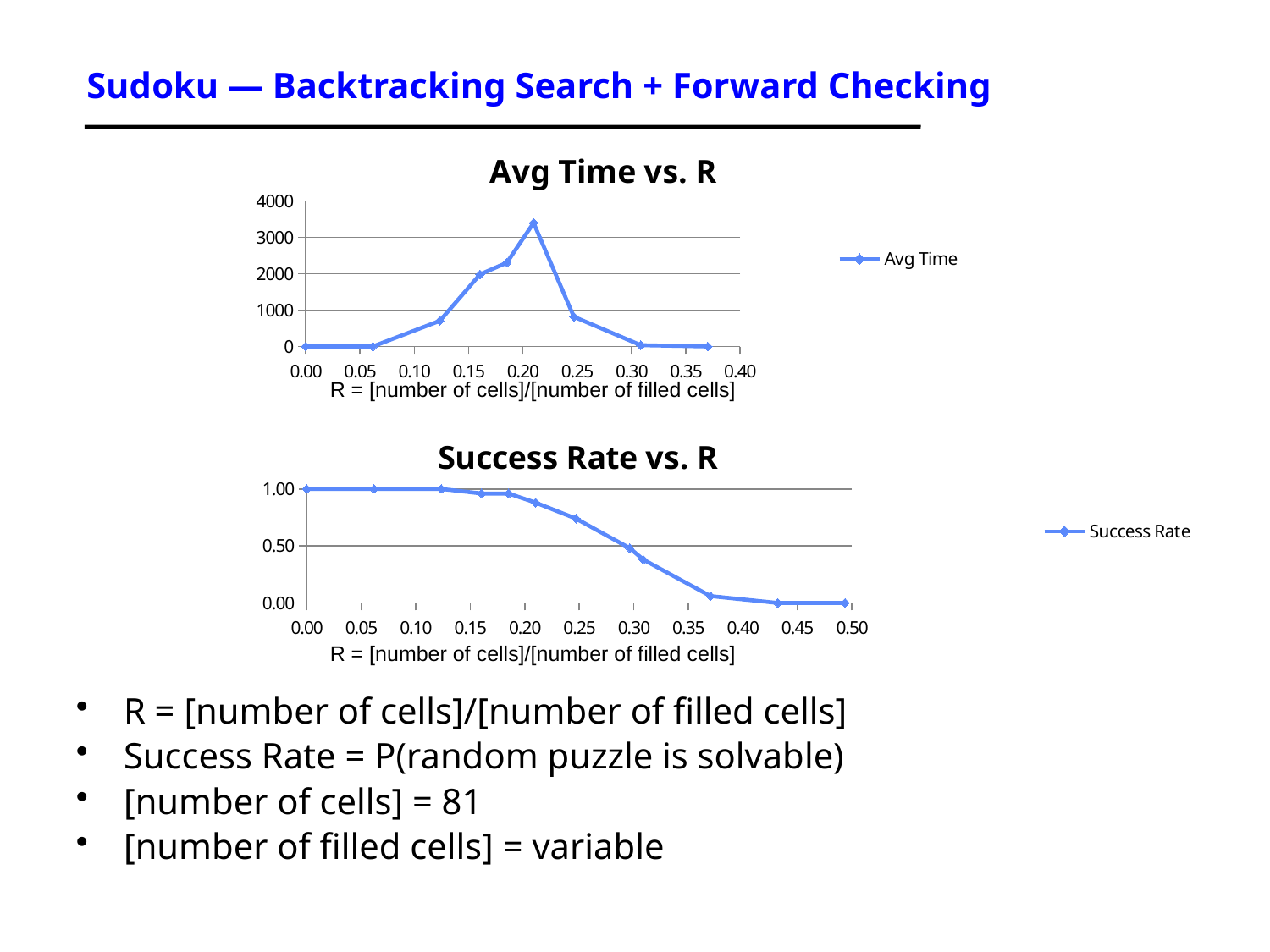
What is the legend entry of the "Avg Time vs. R" chart? Avg Time What kind of chart is the "Avg Time vs. R" chart? line chart How many series does the legend of the "Success Rate vs. R" chart list? 1 What is the x-axis title of the "Success Rate vs. R" chart? R = [number of cells]/[number of filled cells] In the "Avg Time vs. R" chart, is the highest plotted value greater or less than 3000? greater In the "Success Rate vs. R" chart, is the value at R = 0.50 greater or less than 0.50? less In the "Success Rate vs. R" chart, is the value at R = 0.00 greater or less than 0.50? greater How many series does the legend of the "Avg Time vs. R" chart list? 1 What kind of chart is the "Success Rate vs. R" chart? line chart In the "Success Rate vs. R" chart, do the values generally rise or fall as R increases? fall In the "Success Rate vs. R" chart, which is larger: the value at R = 0.00 or the value at R = 0.40? R = 0.00